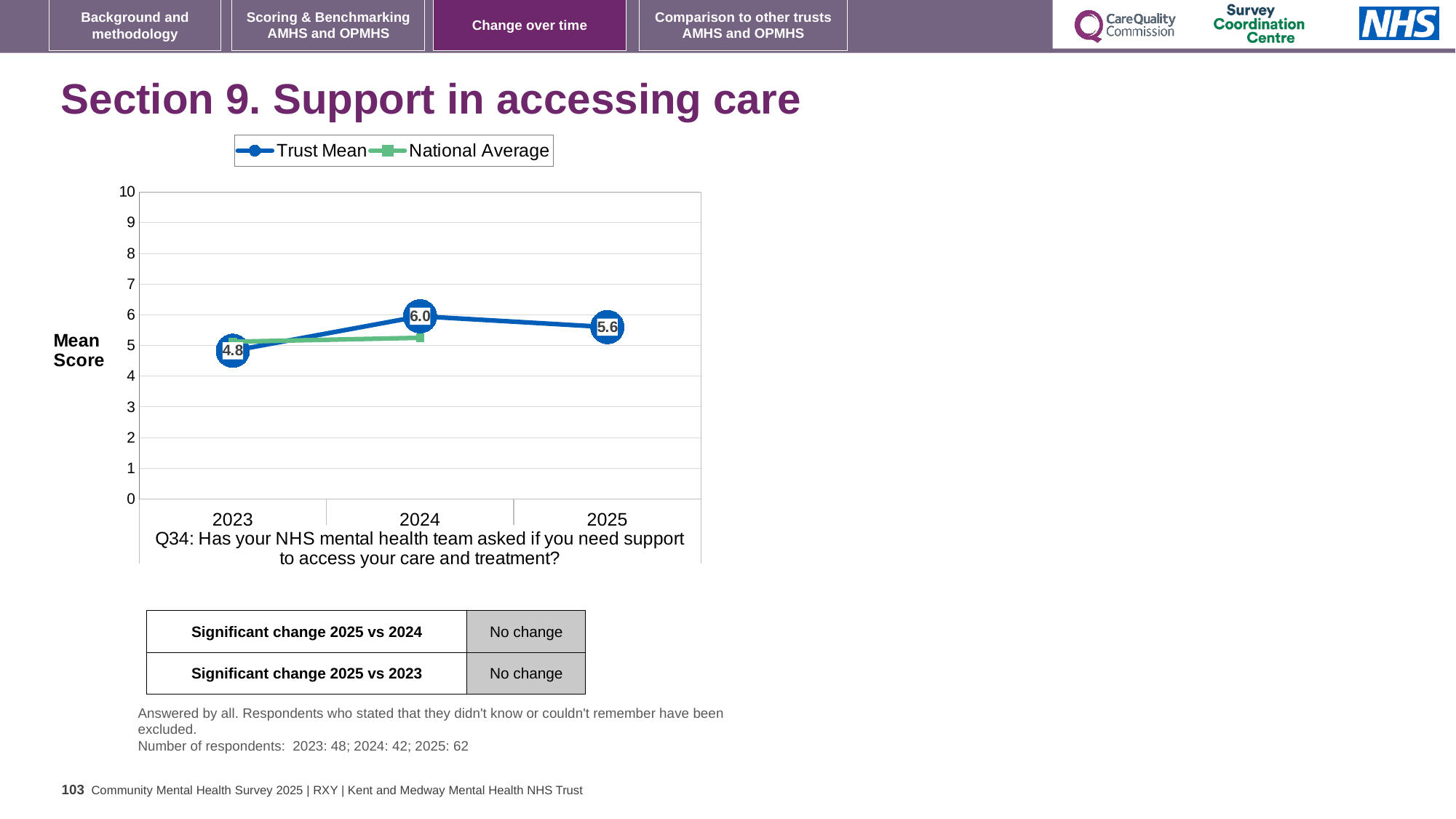
How many years are shown on the x axis of the chart? 3 What is the Trust Mean score for 2024? 6.0 In which year is the Trust Mean score highest? 2024 Does the Trust Mean score rise or fall from 2024 to 2025? Fall What is the Trust Mean score for 2023? 4.8 How many series does the chart legend list? 2 What is the Trust Mean score for 2025? 5.6 What kind of chart is shown on the slide? Line chart Which year has the larger Trust Mean score, 2025 or 2023? 2025 What is the difference between the Trust Mean scores for 2024 and 2023? 1.2 In which year is the Trust Mean score lowest? 2023 Is the National Average value for 2024 greater or less than 6? less